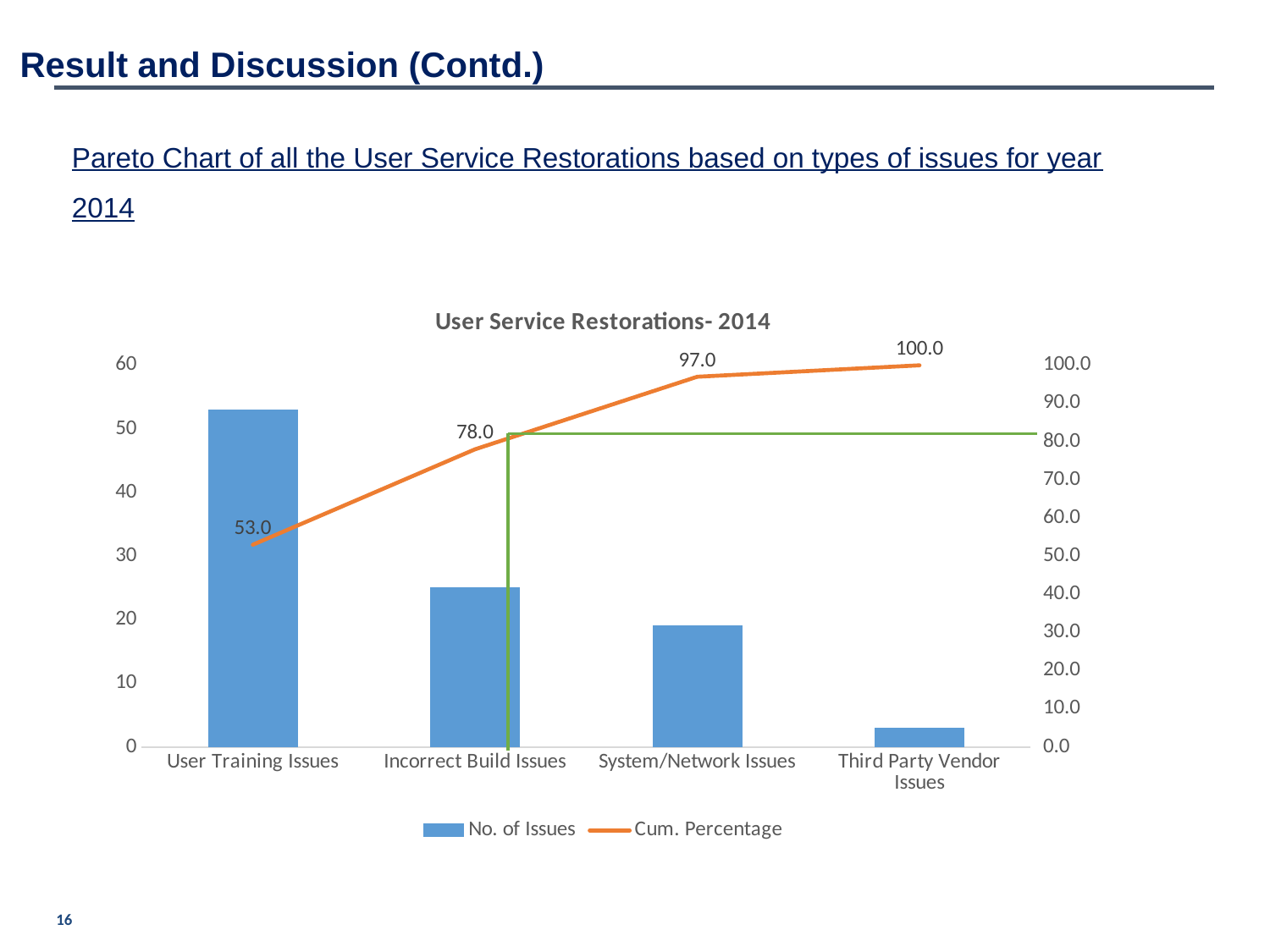
How many series does the legend list? 2 Which category has the highest No. of Issues? User Training Issues Does the Cum. Percentage line rise or fall from left to right across the categories? rise What is the Cum. Percentage value for System/Network Issues? 97.0 What is the difference between the Cum. Percentage values for Incorrect Build Issues and User Training Issues? 25.0 Which category has the lowest No. of Issues? Third Party Vendor Issues What is the title of the chart? User Service Restorations- 2014 How many categories are shown on the x axis? 4 What is the Cum. Percentage value for Incorrect Build Issues? 78.0 Is the No. of Issues for Incorrect Build Issues greater or less than 30? less What is the Cum. Percentage value for Third Party Vendor Issues? 100.0 What is the Cum. Percentage value for User Training Issues? 53.0